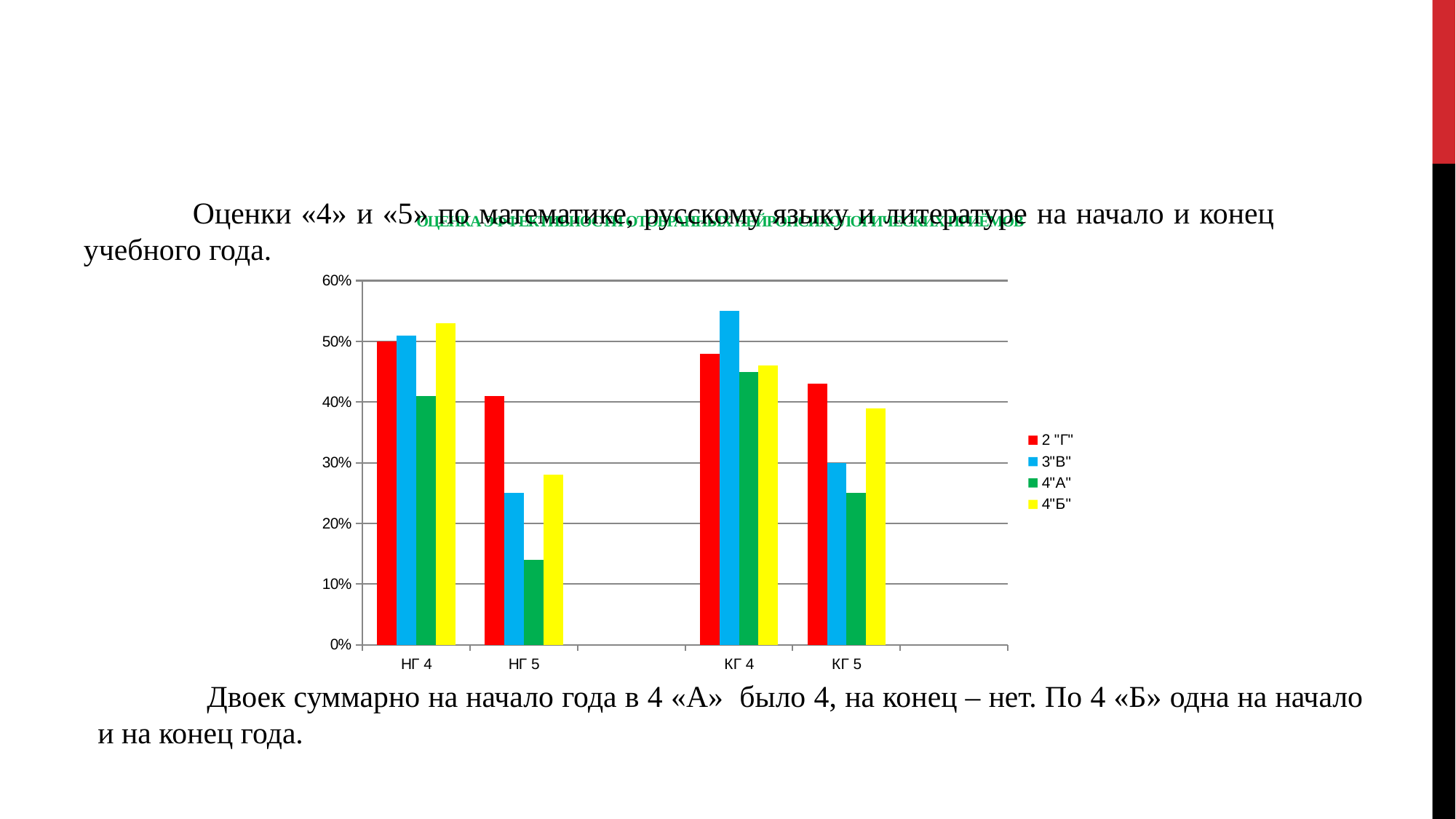
Is the value for 4"А" in the НГ 5 category greater or less than 20%? less What colour are the bars for the 4"Б" series? yellow In the НГ 5 category, which is larger: the value for 2 "Г" or the value for 3"В"? 2 "Г" Which series has the highest value in the НГ 5 category? 2 "Г" Which series has the highest value in the КГ 4 category? 3"В" Which series has the lowest value in the НГ 5 category? 4"А" How many categories are shown on the x axis? 4 Is the value for 3"В" in the КГ 4 category greater or less than 50%? greater How many series does the legend list? 4 Is the value for 4"Б" in the НГ 5 category greater or less than 20%? greater Which series has the lowest value in the КГ 5 category? 4"А" What kind of chart is shown on the slide? bar chart